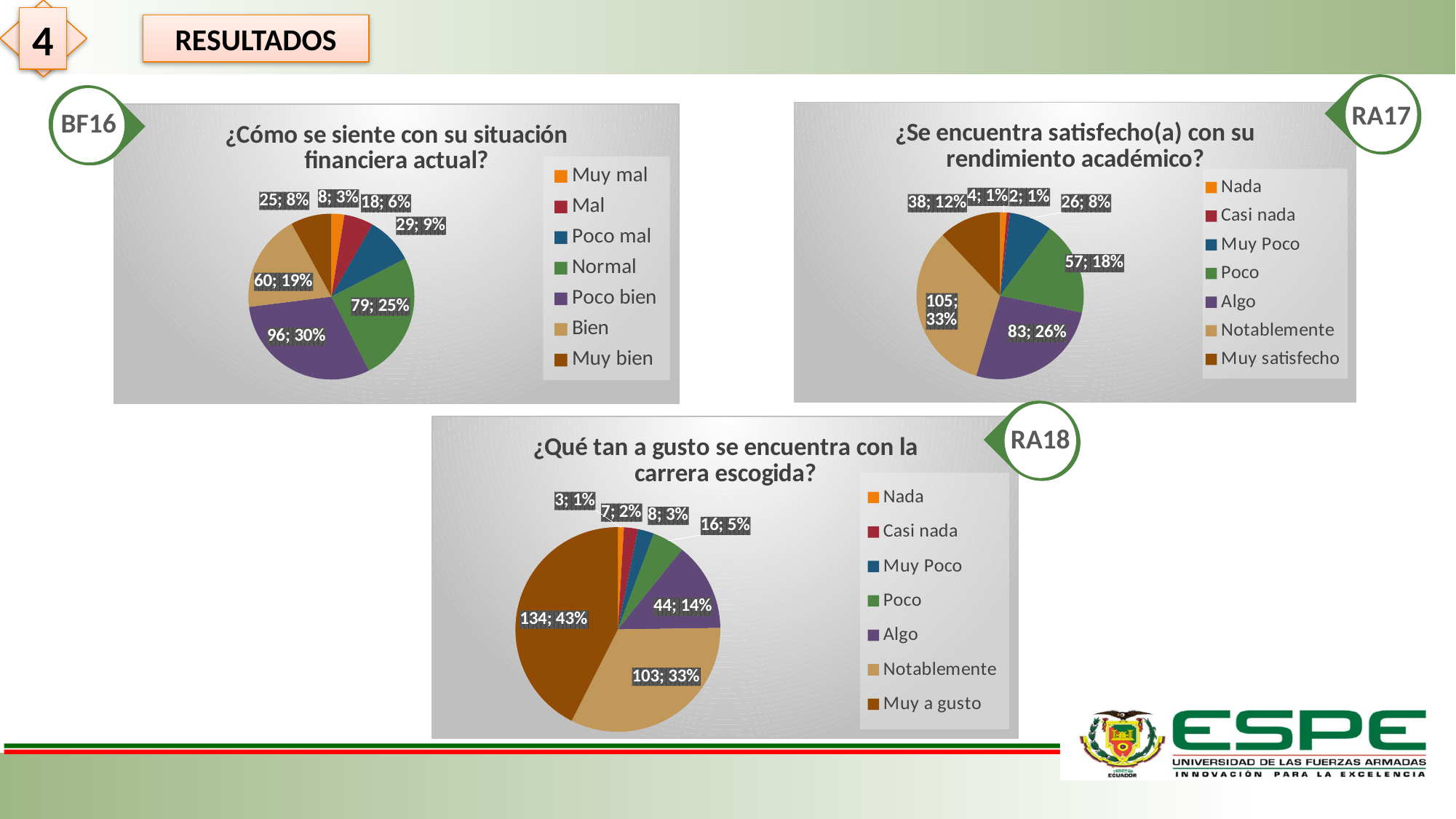
In the chart titled '¿Se encuentra satisfecho(a) con su rendimiento académico?', what is the count and percentage for 'Notablemente'? 105; 33% In the chart titled '¿Se encuentra satisfecho(a) con su rendimiento académico?', which is larger, 'Poco' or 'Muy satisfecho'? Poco In the chart titled '¿Cómo se siente con su situación financiera actual?', which category has the smallest slice? Muy mal In the chart titled '¿Qué tan a gusto se encuentra con la carrera escogida?', what is the difference in count between 'Muy a gusto' and 'Notablemente'? 31 In the chart titled '¿Qué tan a gusto se encuentra con la carrera escogida?', what is the count and percentage for 'Muy a gusto'? 134; 43% In the chart titled '¿Cómo se siente con su situación financiera actual?', how many categories does the legend list? 7 What type of chart is used for '¿Qué tan a gusto se encuentra con la carrera escogida?'? Pie chart In the chart titled '¿Cómo se siente con su situación financiera actual?', what is the difference in count between 'Normal' and 'Bien'? 19 In the chart titled '¿Cómo se siente con su situación financiera actual?', what is the count and percentage for 'Poco bien'? 96; 30% In the chart titled '¿Qué tan a gusto se encuentra con la carrera escogida?', what colour is the 'Muy a gusto' slice? Brown In the chart titled '¿Se encuentra satisfecho(a) con su rendimiento académico?', what share of the pie does 'Algo' represent? 26% In the chart titled '¿Se encuentra satisfecho(a) con su rendimiento académico?', which category has the largest slice? Notablemente